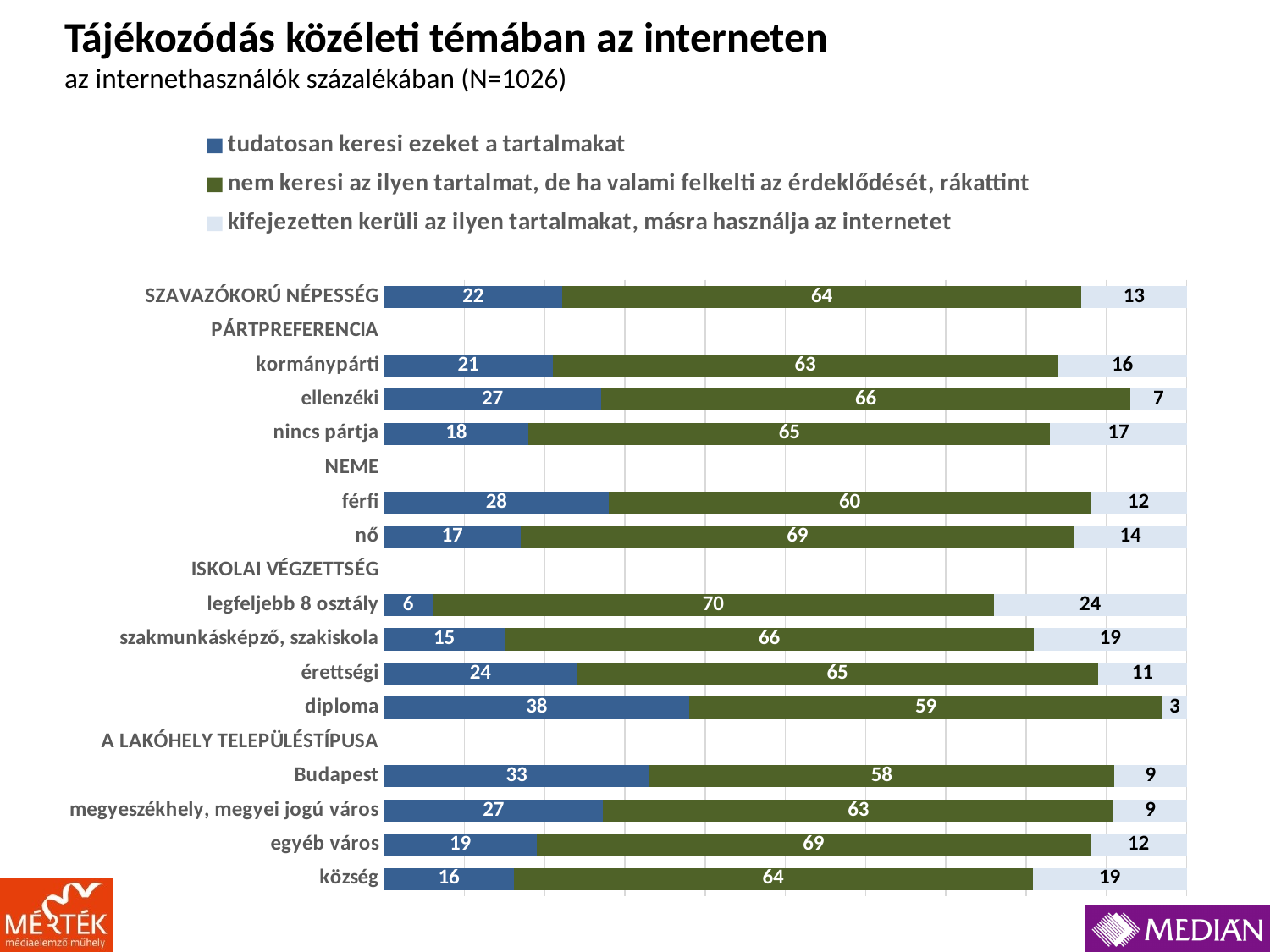
What is the total of the stacked bar for ellenzéki? 100 How many series does the legend list? 3 Which category has the lowest value for "kifejezetten kerüli az ilyen tartalmakat, másra használja az internetet"? diploma What is the value of "tudatosan keresi ezeket a tartalmakat" for diploma? 38 Which has a larger "tudatosan keresi ezeket a tartalmakat" value, Budapest or község? Budapest How many categories have bars plotted in the chart? 14 Which category has the highest value for "tudatosan keresi ezeket a tartalmakat"? diploma What is the difference between the "tudatosan keresi ezeket a tartalmakat" values for férfi and nő? 11 What is the value of "kifejezetten kerüli az ilyen tartalmakat, másra használja az internetet" for legfeljebb 8 osztály? 24 What is the value of "nem keresi az ilyen tartalmat, de ha valami felkelti az érdeklődését, rákattint" for nő? 69 What is the title of the chart? Tájékozódás közéleti témában az interneten What kind of chart is shown on the slide? stacked bar chart